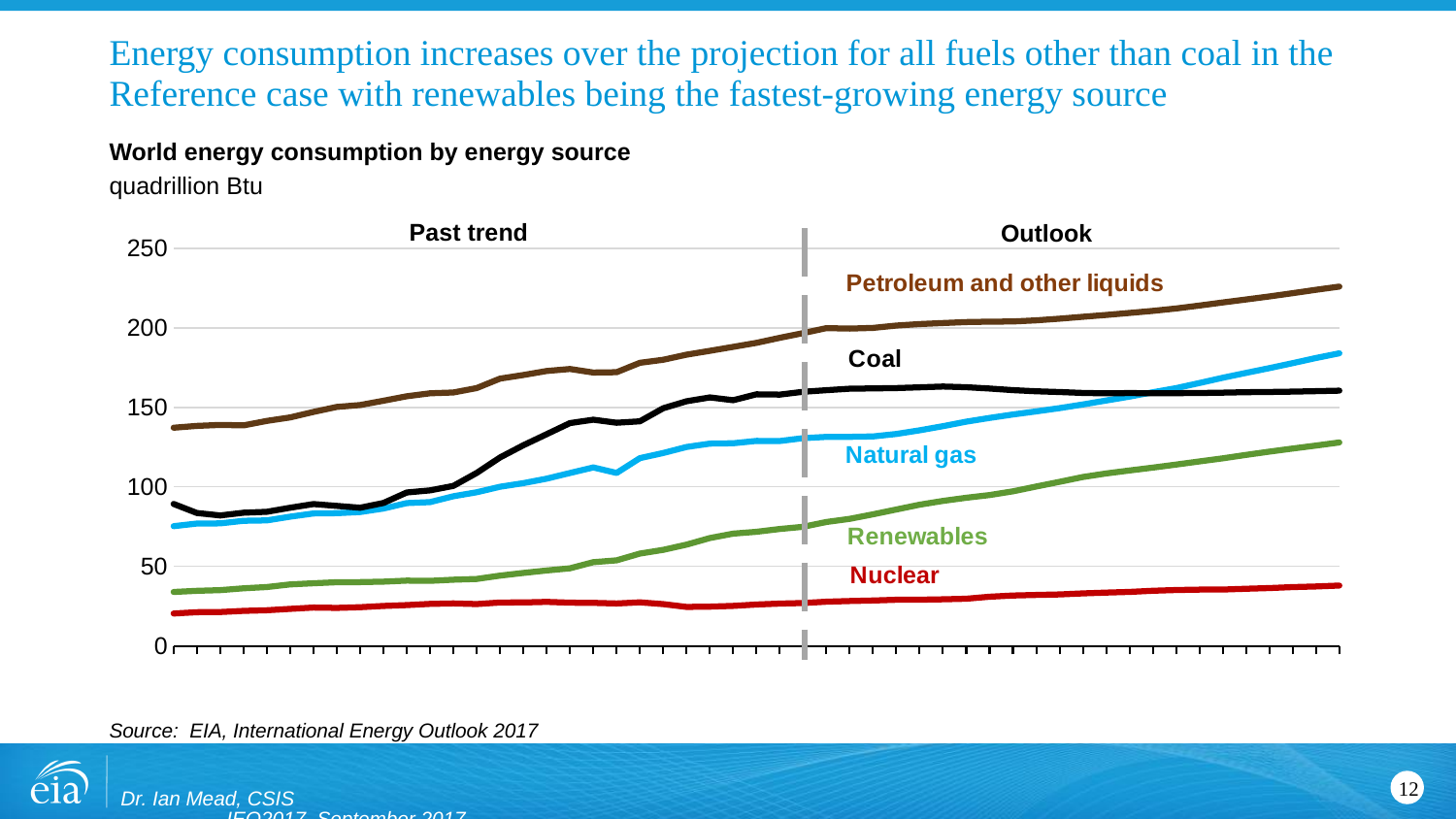
What is the title of the chart? World energy consumption by energy source What unit is the energy consumption measured in on this chart? quadrillion Btu Is the value for Nuclear at the end of the outlook greater or less than 50? less Is the value for Natural gas at the end of the outlook greater or less than 150? greater How many energy sources (series) are plotted on the chart? 5 Does the Renewables line rise or fall over the outlook period? rise Which energy source has the lowest consumption throughout the chart? Nuclear Is the value for Petroleum and other liquids at the end of the outlook greater or less than 200? greater Which energy source has the highest consumption at the end of the projection? Petroleum and other liquids At the end of the outlook period, which is larger: Natural gas or Coal? Natural gas What kind of chart is shown on the slide? line chart